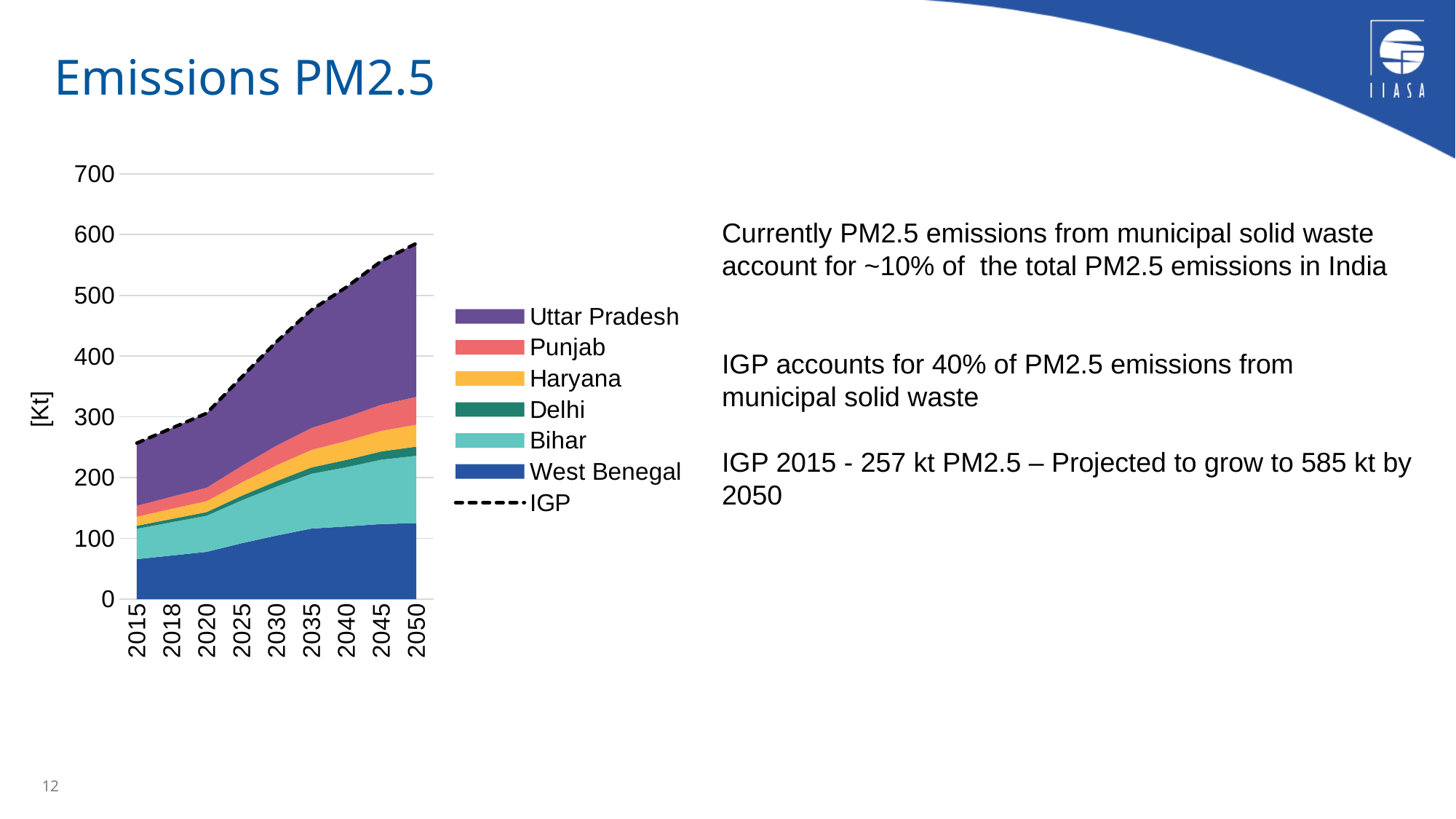
What kind of chart is shown on the slide? Stacked area chart with a dashed line Is the IGP value in 2015 greater or less than 300? less What is the unit shown on the y axis of the chart? [Kt] By how much are IGP PM2.5 emissions projected to grow between 2015 and 2050, based on the values stated on the slide? 328 kt What is the projected IGP PM2.5 emission value for 2050 stated on the slide? 585 kt Is the IGP value in 2050 greater or less than 500? greater Is the West Benegal value in 2050 greater or less than 100? greater How many series does the chart legend list? 7 Which state contributes the largest share of emissions in 2050? Uttar Pradesh Do the IGP emissions rise or fall from 2015 to 2050? Rise What is the IGP PM2.5 emission value for 2015 stated on the slide? 257 kt How many years are shown on the x axis of the chart? 9